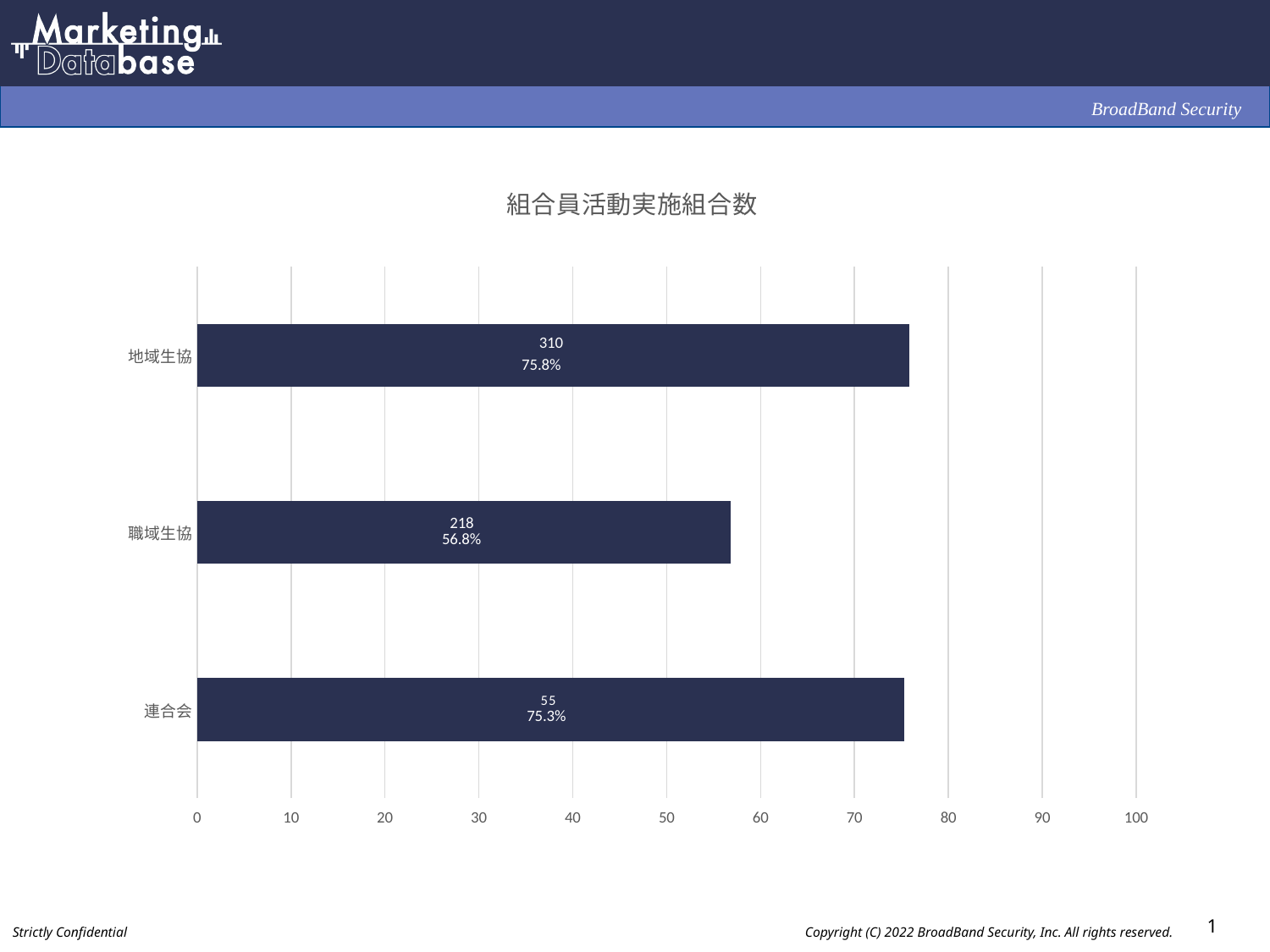
What percentage is labelled on the bar for 地域生協? 75.8% How many categories are plotted in the chart? 3 What is the difference between the counts for 地域生協 and 職域生協? 92 What count is labelled on the bar for 職域生協? 218 Which has the higher percentage, 地域生協 or 職域生協? 地域生協 What is the title of the chart? 組合員活動実施組合数 What count is labelled on the bar for 連合会? 55 What type of chart is shown on the slide? bar chart What count is labelled on the bar for 地域生協? 310 What percentage is labelled on the bar for 職域生協? 56.8% What percentage is labelled on the bar for 連合会? 75.3% Which category has the lowest percentage? 職域生協